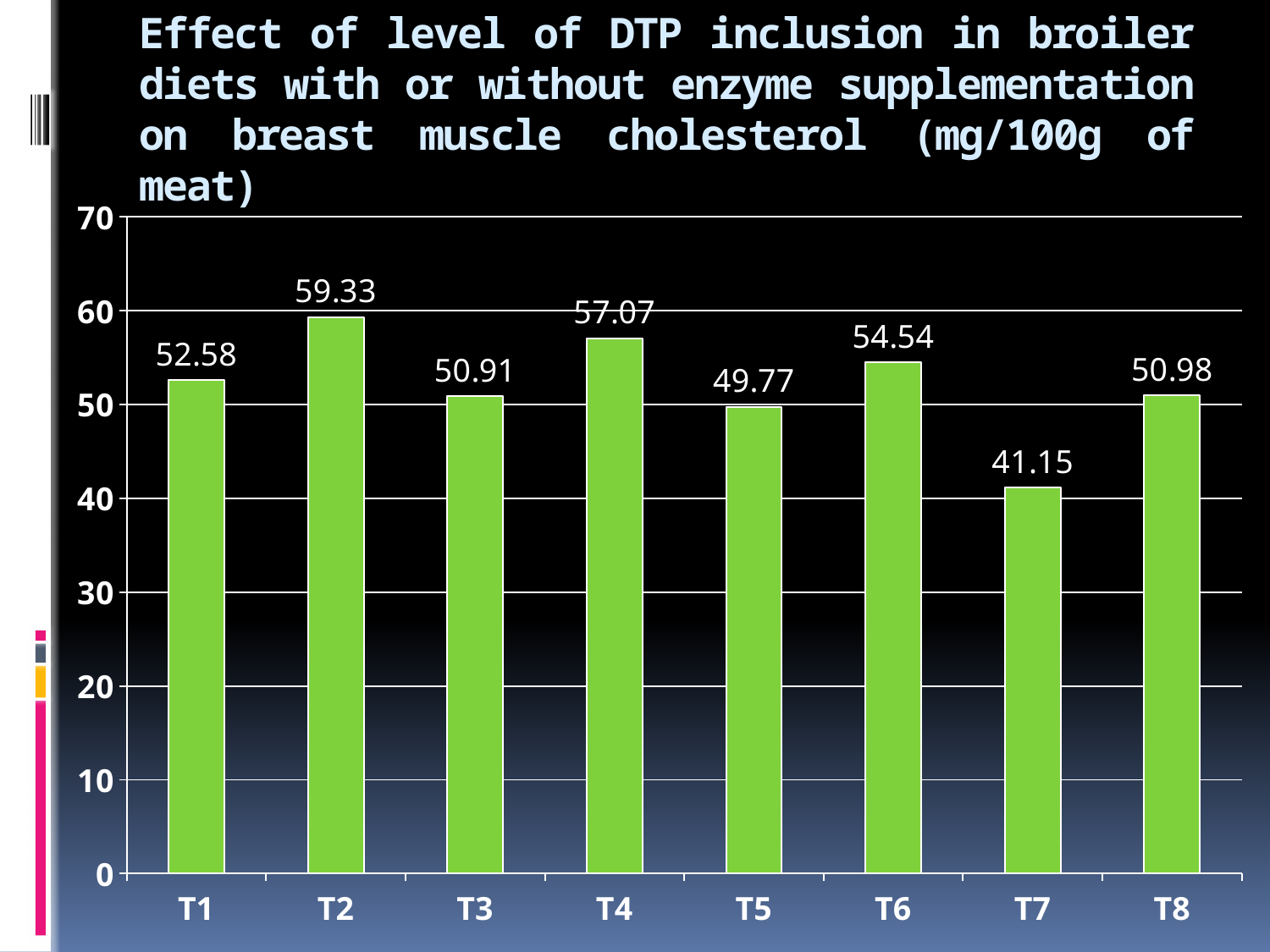
What is the difference between the values for T2 and T7? 18.18 What kind of chart is shown on the slide? bar chart What unit is breast muscle cholesterol measured in, according to the chart title? mg/100g of meat How many treatments are shown on the x axis? 8 What is the value shown for T7? 41.15 Which treatment has the lowest breast muscle cholesterol? T7 Which treatment has the highest breast muscle cholesterol? T2 What is the difference between the values for T4 and T3? 6.16 Is the value for T5 greater or less than 50? less What is the breast muscle cholesterol value for T2? 59.33 Which is larger, the value for T1 or the value for T6? T6 What is the value shown for T5? 49.77